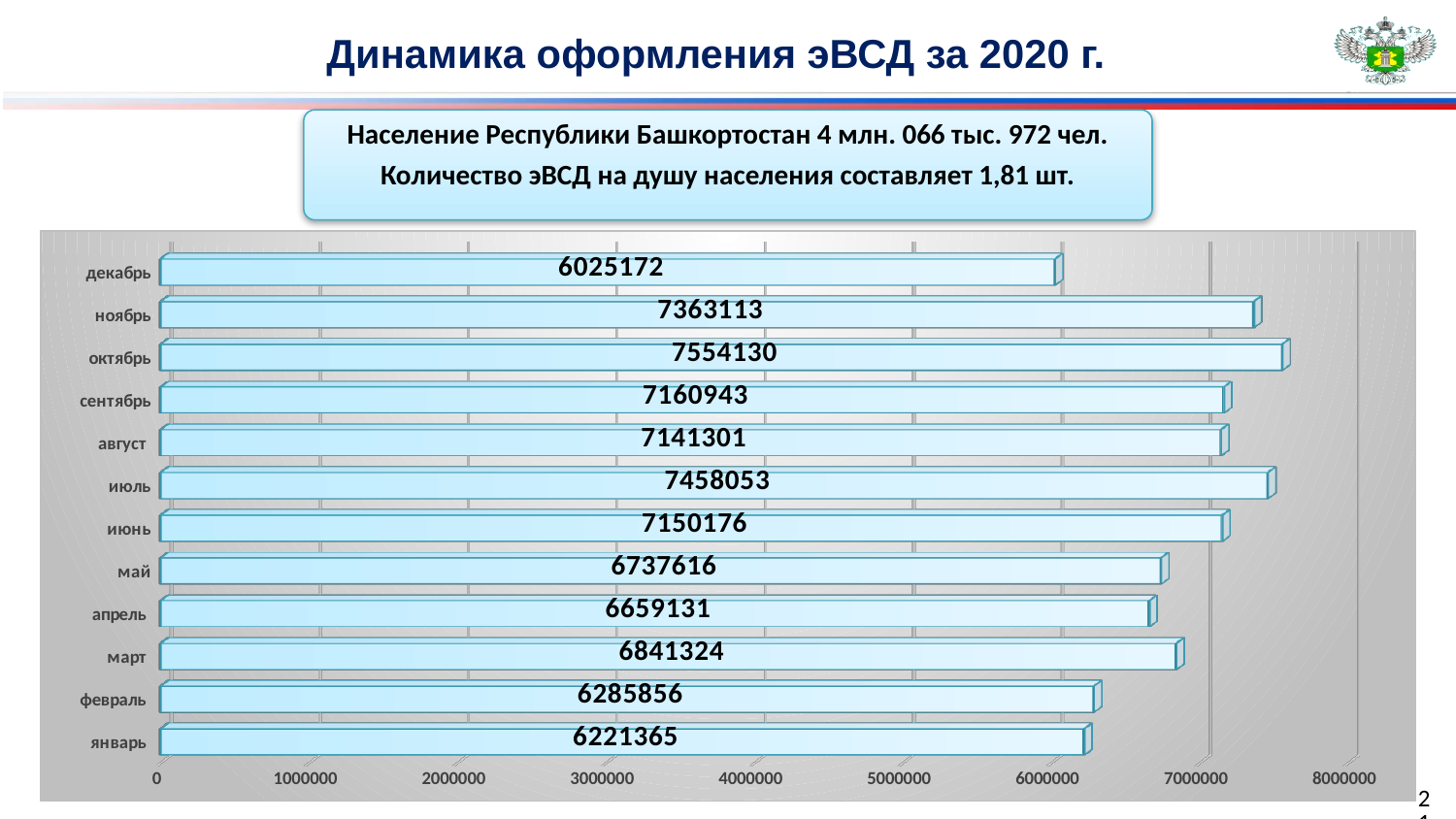
How many months are shown in the chart? 12 What is the value for октябрь? 7554130 What is the value for май? 6737616 Which is larger, the value for июль or the value for ноябрь? июль What is the difference between the values for февраль and январь? 64491 What is the title of the slide? Динамика оформления эВСД за 2020 г. Which month has the lowest value? декабрь What kind of chart is shown on the slide? bar chart What is the value for январь? 6221365 Which month has the highest value? октябрь What is the difference between the values for октябрь and декабрь? 1528958 Is the value for апрель greater or less than 7000000? less